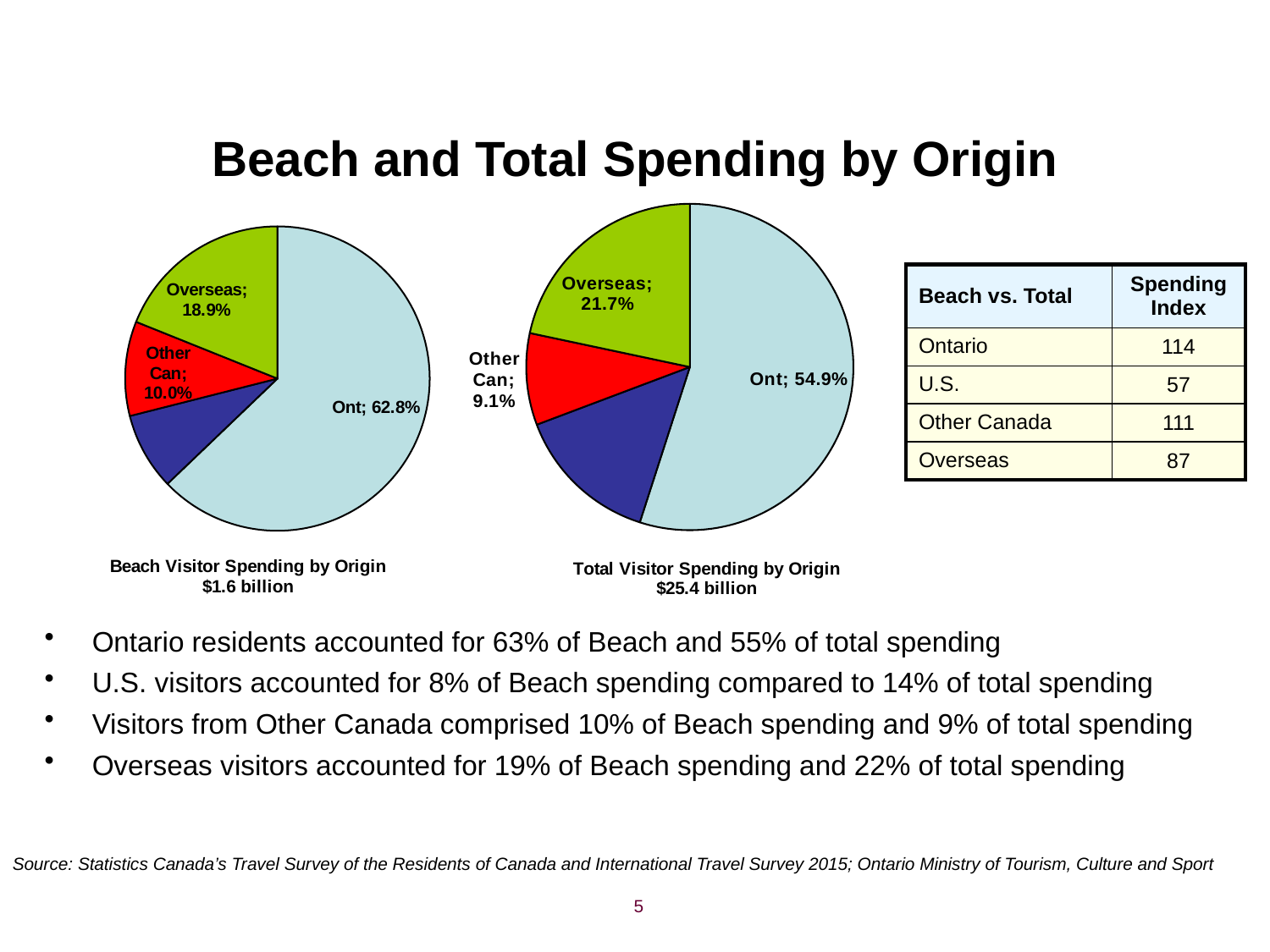
In the Beach Visitor Spending by Origin chart, what is the difference between the Overseas share and the Other Can share? 8.9 percentage points In the Total Visitor Spending by Origin chart, what share of spending is attributed to Ont? 54.9% In the Beach Visitor Spending by Origin chart, which labelled origin has the largest share? Ont What is the difference between the Ont share in the Beach Visitor Spending by Origin chart and the Ont share in the Total Visitor Spending by Origin chart? 7.9 percentage points What type of chart is used to show Beach Visitor Spending by Origin? Pie chart Is the Overseas share larger in the Beach Visitor Spending by Origin chart or in the Total Visitor Spending by Origin chart? Total Visitor Spending by Origin In the Total Visitor Spending by Origin chart, what share of spending is attributed to Overseas? 21.7% What total dollar amount is shown beneath the Total Visitor Spending by Origin chart? $25.4 billion In the Total Visitor Spending by Origin chart, which labelled origin has the smallest share? Other Can In the Beach Visitor Spending by Origin chart, what share of spending is attributed to Other Can? 10.0% In the Beach Visitor Spending by Origin chart, what share of spending is attributed to Ont? 62.8% How many slices does the Total Visitor Spending by Origin chart have? 4